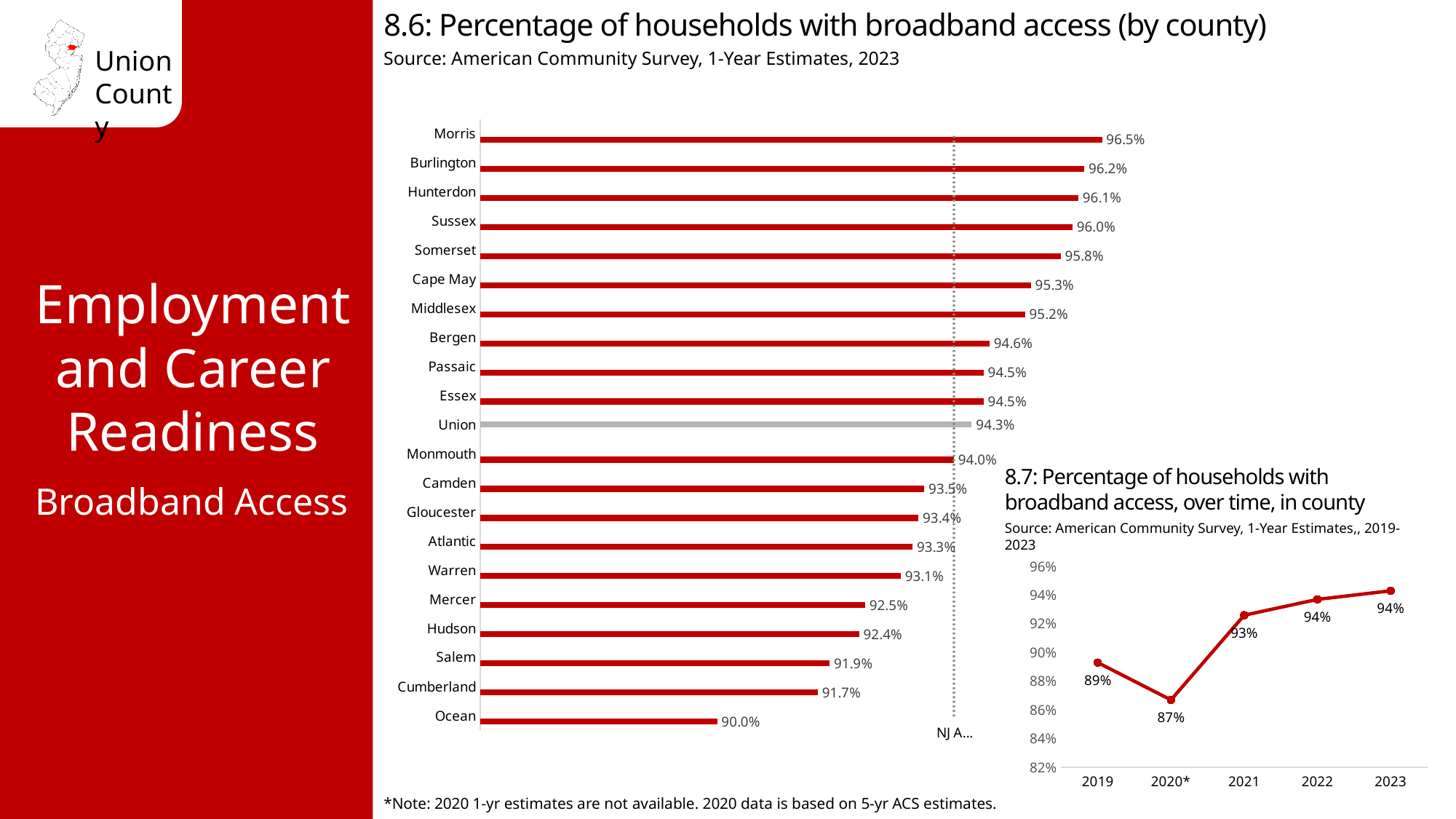
In chart 8.6 (broadband access by county), what is the value for Union? 94.3% In chart 8.7 (broadband access over time), how many data points are plotted? 5 In chart 8.7 (broadband access over time), which year has the lowest value? 2020* In chart 8.6 (broadband access by county), what is the difference between Morris and Ocean? 6.5 percentage points In chart 8.7 (broadband access over time), do values rise or fall from 2020* to 2023? Rise In chart 8.6 (broadband access by county), how many counties are shown? 21 In chart 8.6 (broadband access by county), which county has the lowest percentage? Ocean What kind of chart is chart 8.6 (broadband access by county)? Bar chart In chart 8.6 (broadband access by county), which is larger, the value for Bergen or the value for Mercer? Bergen In chart 8.6 (broadband access by county), which county has the highest percentage? Morris In chart 8.7 (broadband access over time), what is the value for 2021? 93% In chart 8.6 (broadband access by county), what is the value for Cumberland? 91.7%